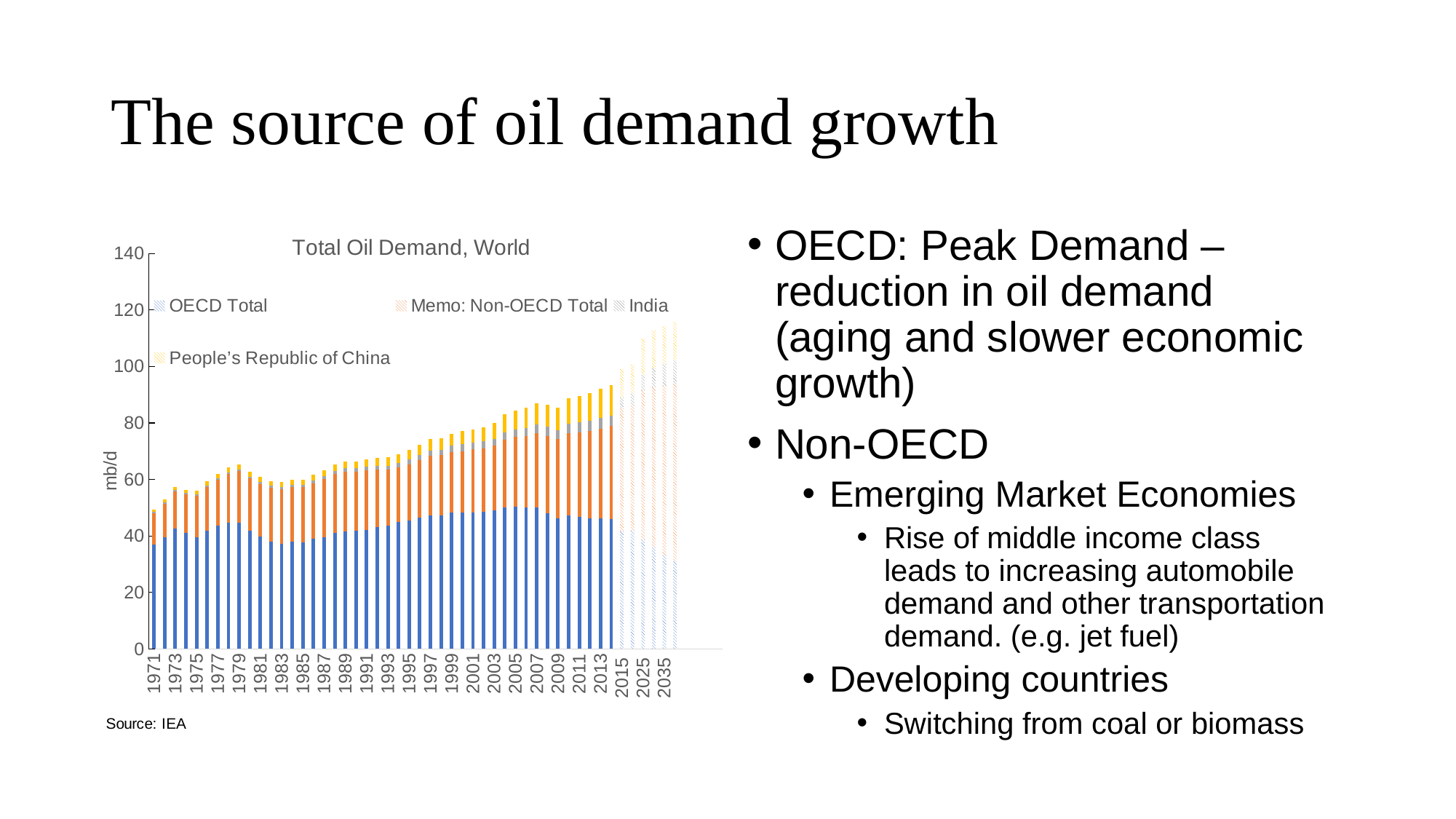
Overall, does total oil demand rise or fall from 1971 to 2035? rise What is the title of the chart? Total Oil Demand, World Is the total oil demand for 2013 greater or less than 80? greater What unit is shown on the y axis of the chart? mb/d What kind of chart is shown on the slide? bar chart How many series does the legend of the chart list? 4 What is the last year shown on the x axis of the chart? 2035 Is the OECD Total value for 1971 greater or less than 40? less Is the total oil demand for 2035 greater or less than 100? greater Which year has a larger total oil demand, 1979 or 2013? 2013